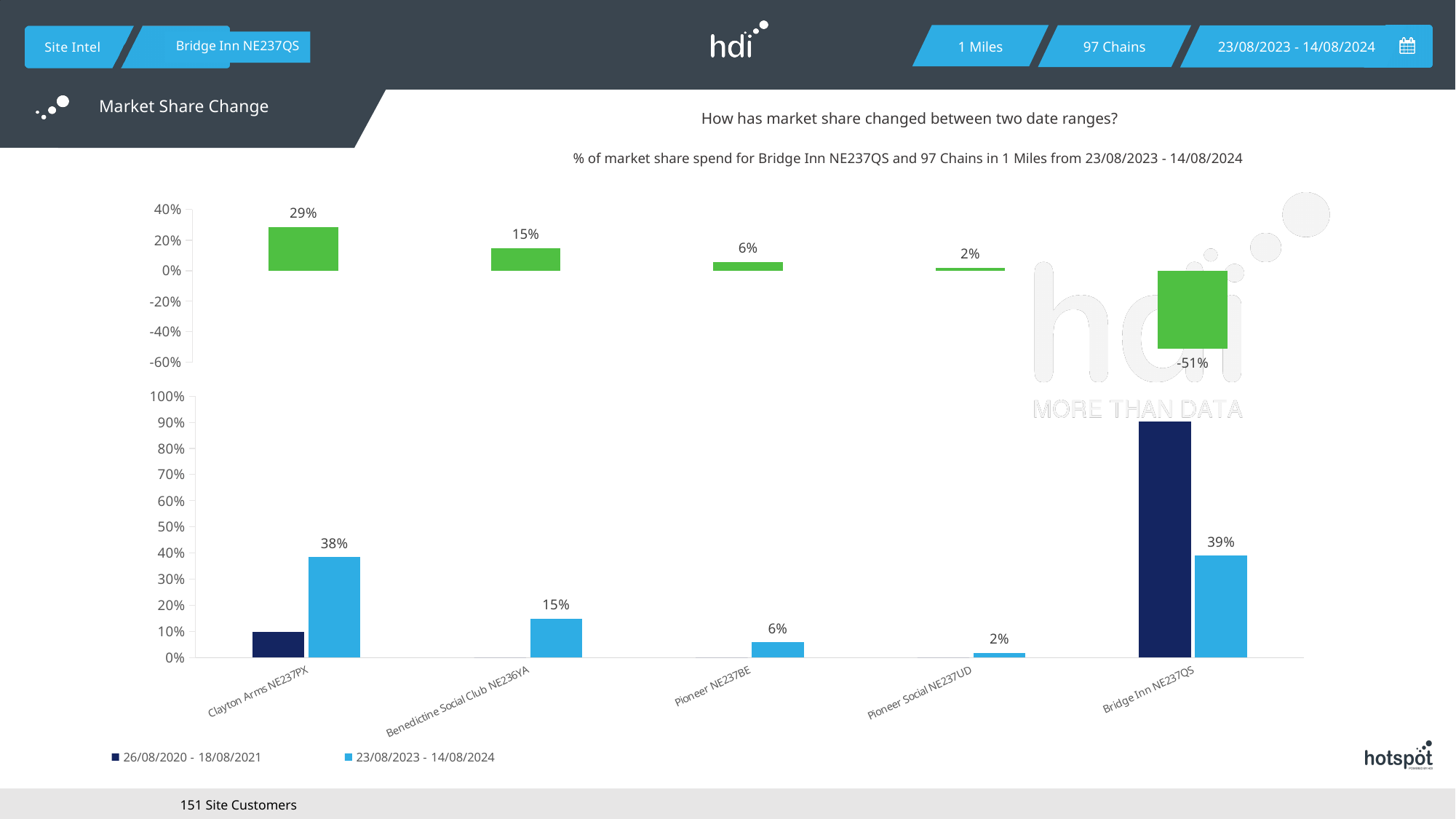
On the top chart (market share change), which category has the lowest value? Bridge Inn NE237QS On the top chart (market share change), what is the value for Clayton Arms NE237PX? 29% On the bottom chart, is the 26/08/2020 - 18/08/2021 value for Bridge Inn NE237QS greater or less than 80%? greater On the top chart (market share change), how many categories are plotted? 5 On the top chart (market share change), what is the difference between the values for Clayton Arms NE237PX and Benedictine Social Club NE236YA? 14% On the bottom chart, what is the 23/08/2023 - 14/08/2024 value for Clayton Arms NE237PX? 38% On the bottom chart, what is the 23/08/2023 - 14/08/2024 value for Bridge Inn NE237QS? 39% What kind of chart is the bottom chart? bar chart On the bottom chart, how many series does the legend list? 2 On the top chart (market share change), which category has the highest value? Clayton Arms NE237PX On the bottom chart, is the 26/08/2020 - 18/08/2021 value for Clayton Arms NE237PX greater or less than 20%? less On the top chart (market share change), what is the value for Bridge Inn NE237QS? -51%